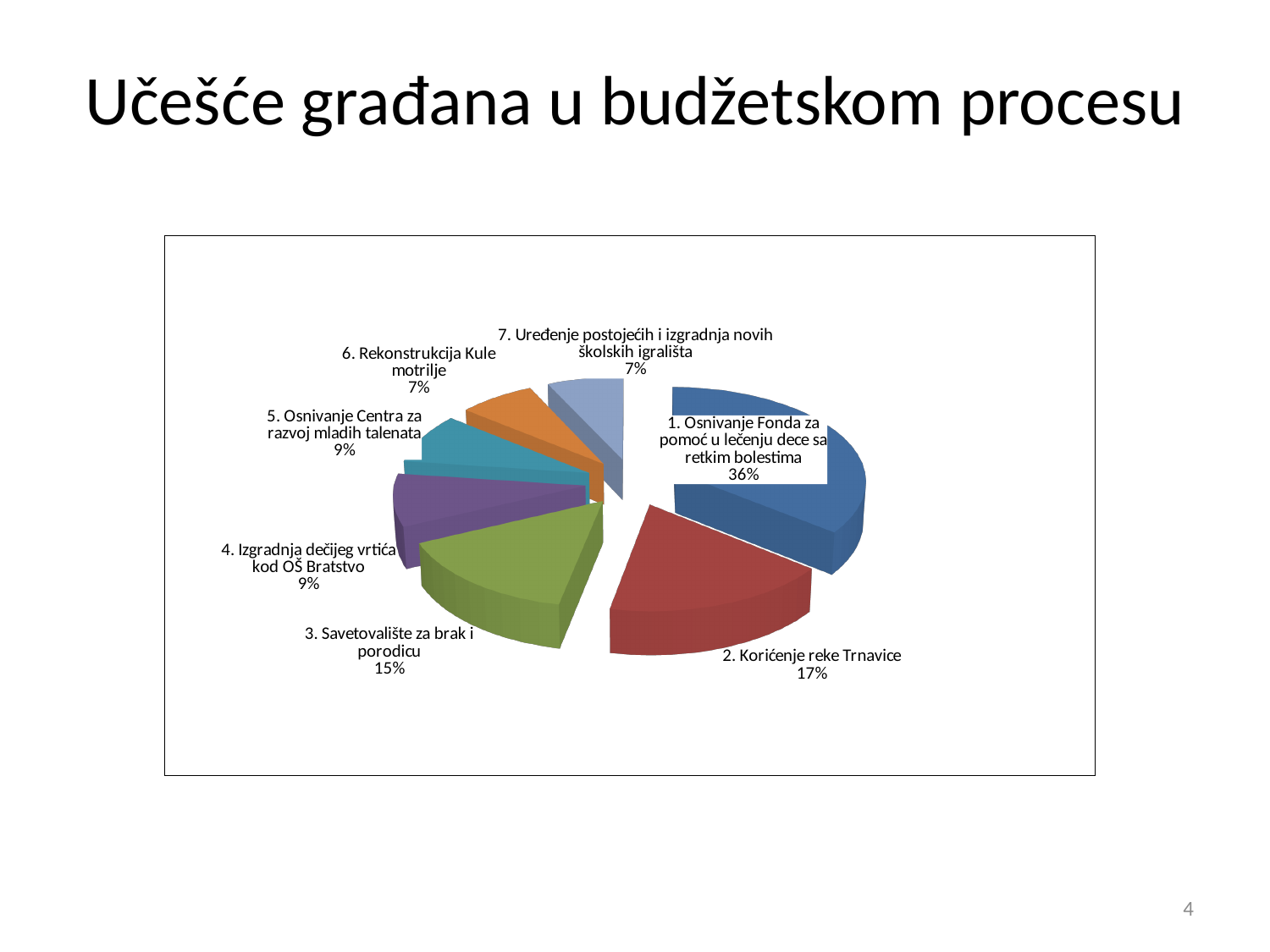
What share of the pie does "1. Osnivanje Fonda za pomoć u lečenju dece sa retkim bolestima" have? 36% What is the combined share of "6. Rekonstrukcija Kule motrilje" and "7. Uređenje postojećih i izgradnja novih školskih igrališta"? 14% How many slices does the pie chart have? 7 What percentage is shown for "4. Izgradnja dečijeg vrtića kod OŠ Bratstvo"? 9% What is the difference in percentage points between "1. Osnivanje Fonda za pomoć u lečenju dece sa retkim bolestima" and "2. Korićenje reke Trnavice"? 19 percentage points Which has a larger share: "3. Savetovalište za brak i porodicu" or "5. Osnivanje Centra za razvoj mladih talenata"? 3. Savetovalište za brak i porodicu Which category has the largest share of the pie? 1. Osnivanje Fonda za pomoć u lečenju dece sa retkim bolestima What is the title of the slide containing the pie chart? Učešće građana u budžetskom procesu What percentage is shown for "2. Korićenje reke Trnavice"? 17% What percentage is shown for "6. Rekonstrukcija Kule motrilje"? 7% What kind of chart is shown on the slide? Pie chart What percentage is shown for "3. Savetovalište za brak i porodicu"? 15%